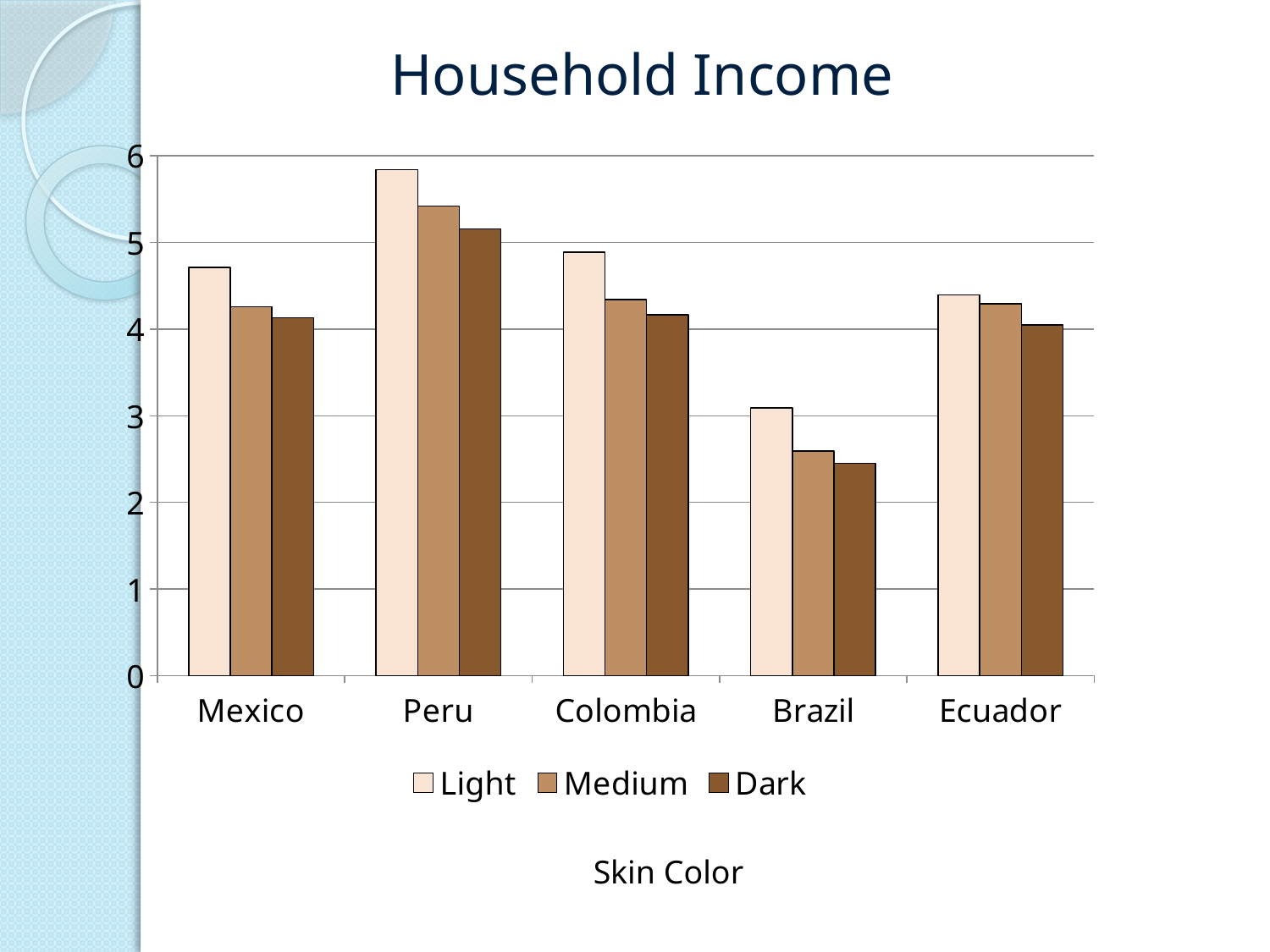
How many countries are shown on the x axis of the Household Income chart? 5 Is the Light value for Brazil greater or less than 4? less Within each country, which series has the tallest bar in the Household Income chart? Light Which is larger, the Light value for Mexico or the Light value for Ecuador? Mexico Is the Light value for Peru greater or less than 5? greater Which country has the lowest Dark bar in the Household Income chart? Brazil What kind of chart is shown on the slide? bar chart How many series does the legend of the Household Income chart list? 3 Is the Medium value for Colombia greater or less than 4? greater Which country has the highest Light bar in the Household Income chart? Peru What is the x-axis label of the Household Income chart? Skin Color